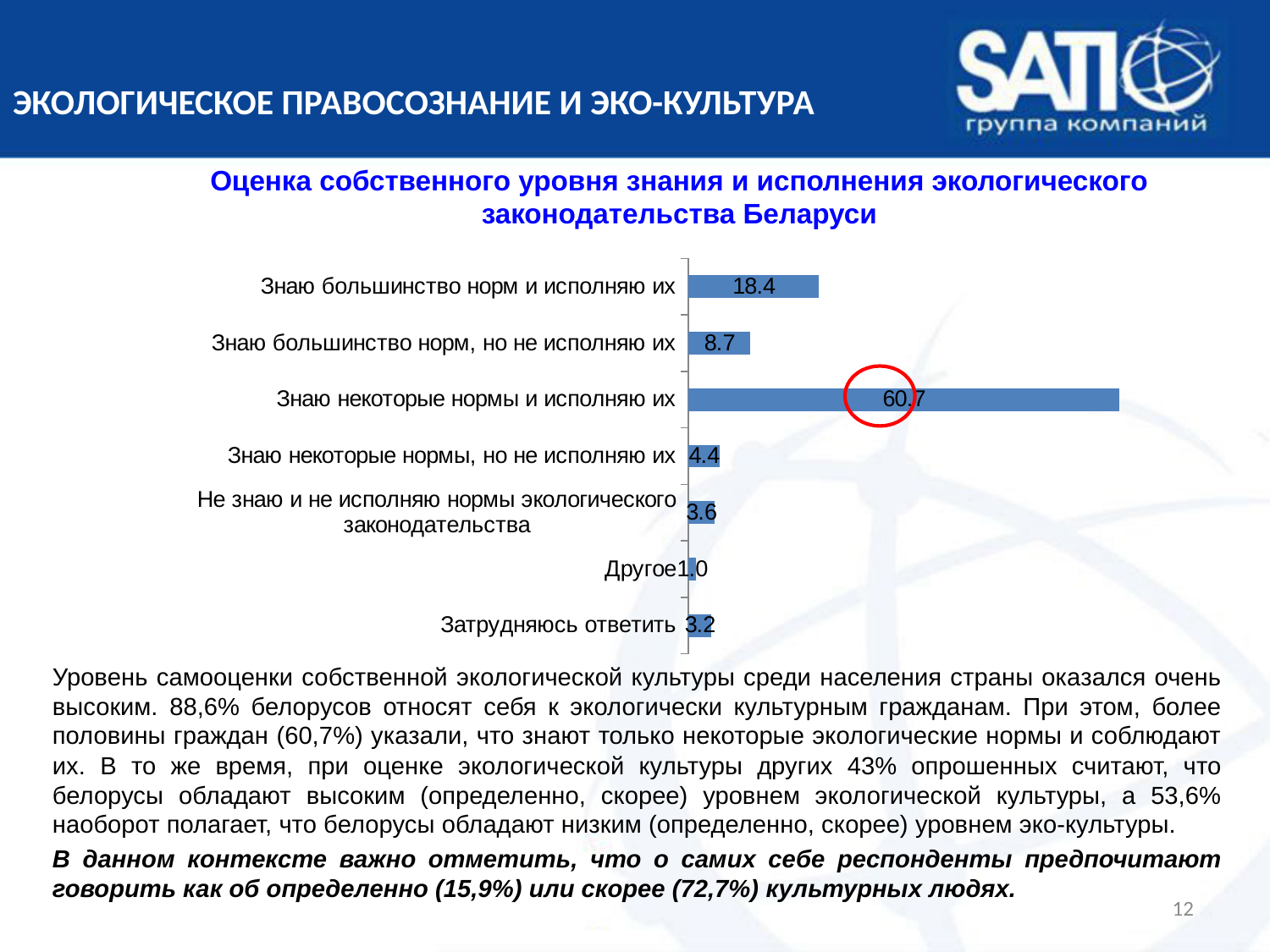
What is the difference between the values for "Знаю некоторые нормы и исполняю их" and "Знаю большинство норм и исполняю их"? 42.3 Which category's data label is circled in red on the chart? Знаю некоторые нормы и исполняю их What value is shown for "Знаю большинство норм, но не исполняю их"? 8.7 Which is larger: the value for "Знаю некоторые нормы, но не исполняю их" or for "Не знаю и не исполняю нормы экологического законодательства"? Знаю некоторые нормы, но не исполняю их What kind of chart is shown on the slide? Bar chart Which category has the highest value? Знаю некоторые нормы и исполняю их How many categories are shown in the chart? 7 What is the difference between the values for "Знаю большинство норм и исполняю их" and "Знаю большинство норм, но не исполняю их"? 9.7 Which category has the lowest value? Другое What value is shown for "Знаю большинство норм и исполняю их"? 18.4 What value is shown for "Затрудняюсь ответить"? 3.2 What value is shown for "Знаю некоторые нормы и исполняю их"? 60.7